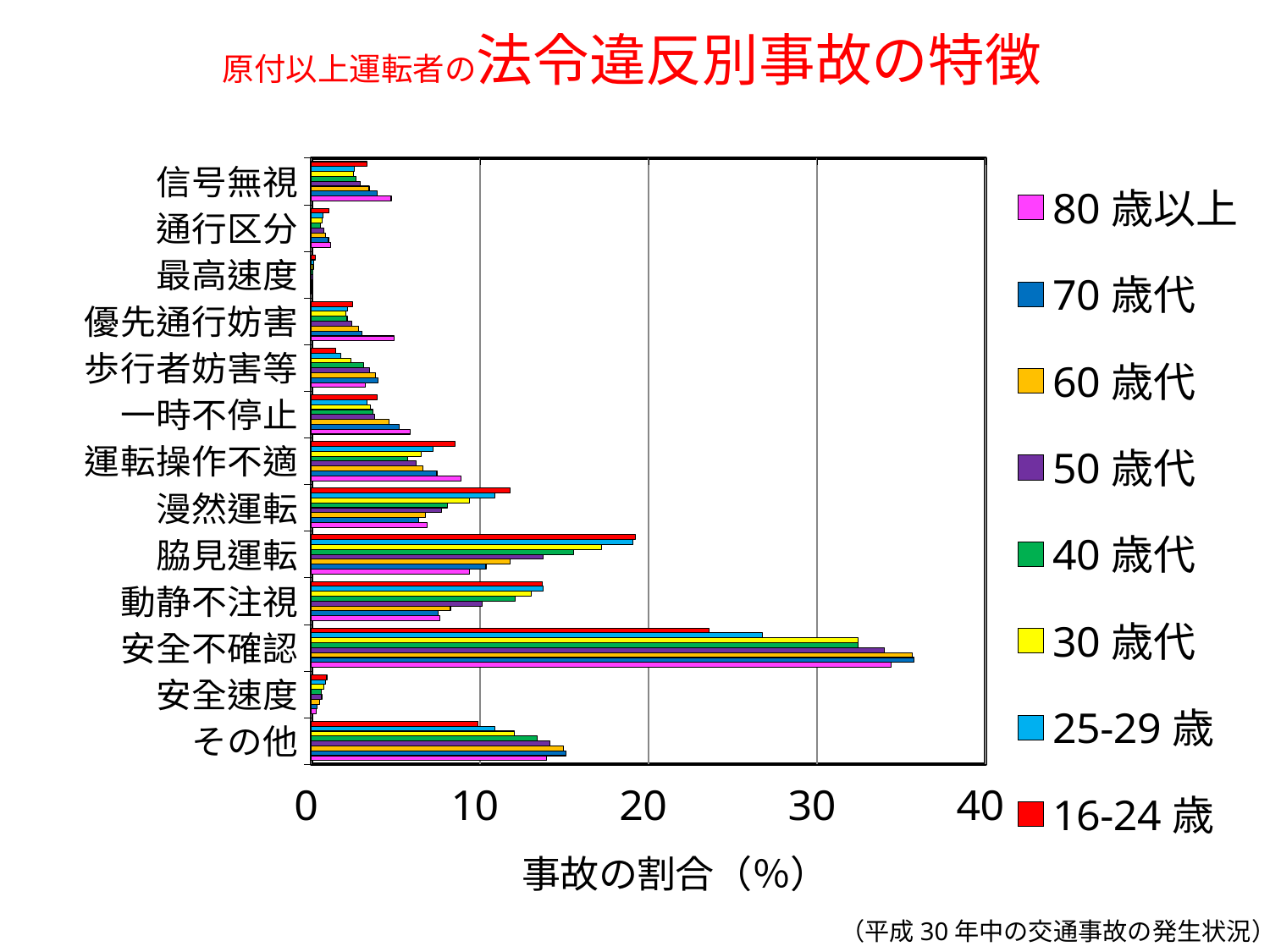
Which violation category has the highest accident share across the age groups? 安全不確認 What is the title of the horizontal axis of the chart? 事故の割合（%） How many violation categories are listed on the vertical axis of the chart? 13 Is the value for 安全不確認 in the 16-24 歳 series greater or less than 20? greater Is the value for その他 in the 16-24 歳 series greater or less than 20? less For 安全不確認, which series has the larger value: 70 歳代 or 16-24 歳? 70 歳代 For 脇見運転, which series has the larger value: 16-24 歳 or 80 歳以上? 16-24 歳 Is the value for 安全不確認 in the 70 歳代 series greater or less than 30? greater How many age-group series does the legend list? 8 Which violation category has the lowest accident share across the age groups? 最高速度 What kind of chart is shown on the slide? bar chart